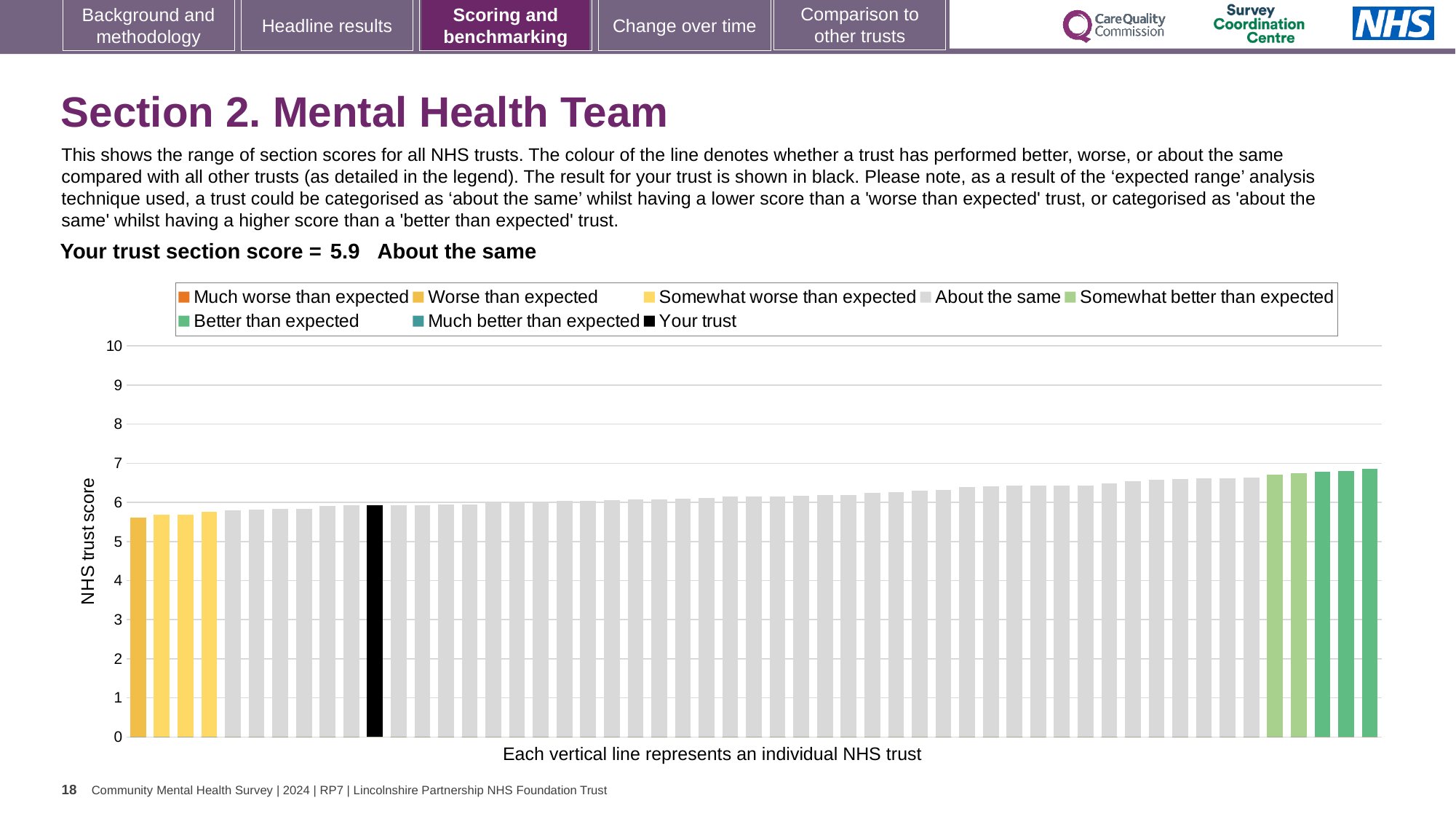
Is the value of the shortest bar greater or less than 5? greater Which category does your trust's section score fall into? About the same What is the section score for your trust shown on the slide? 5.9 What does each vertical line in the chart represent, according to the x-axis label? An individual NHS trust What is the label on the vertical axis of the chart? NHS trust score Do the bar values rise or fall from left to right along the x axis? rise How many entries does the chart legend list? 8 Is the value of the black bar (your trust) greater or less than 5? greater What kind of chart is shown on the slide? Bar chart Is the value of the tallest bar greater or less than 7? less